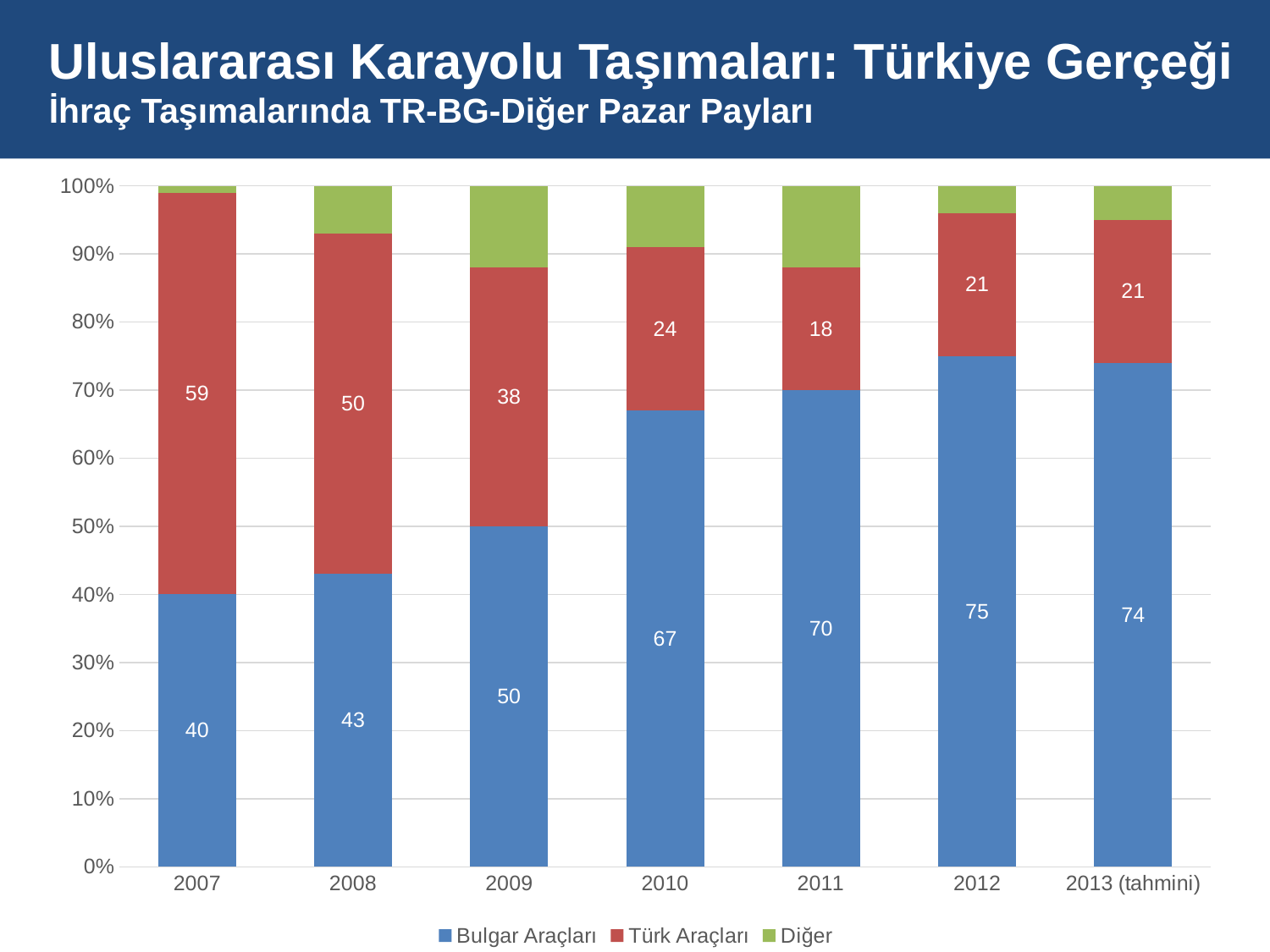
What kind of chart is shown on the slide? Stacked bar chart What is the Bulgar Araçları value for 2010? 67 Is the Diğer share for 2007 greater or less than 10%? less Does the Bulgar Araçları value rise or fall from 2007 to 2012? Rise How many years are shown on the x axis? 7 What is the difference between the Bulgar Araçları values for 2012 and 2007? 35 What is the Türk Araçları value for 2013 (tahmini)? 21 How many series does the legend list? 3 In which year is the Türk Araçları value lowest? 2011 Which is larger: the Türk Araçları value for 2009 or for 2010? 2009 In which year is the Bulgar Araçları value highest? 2012 What is the Türk Araçları value for 2008? 50